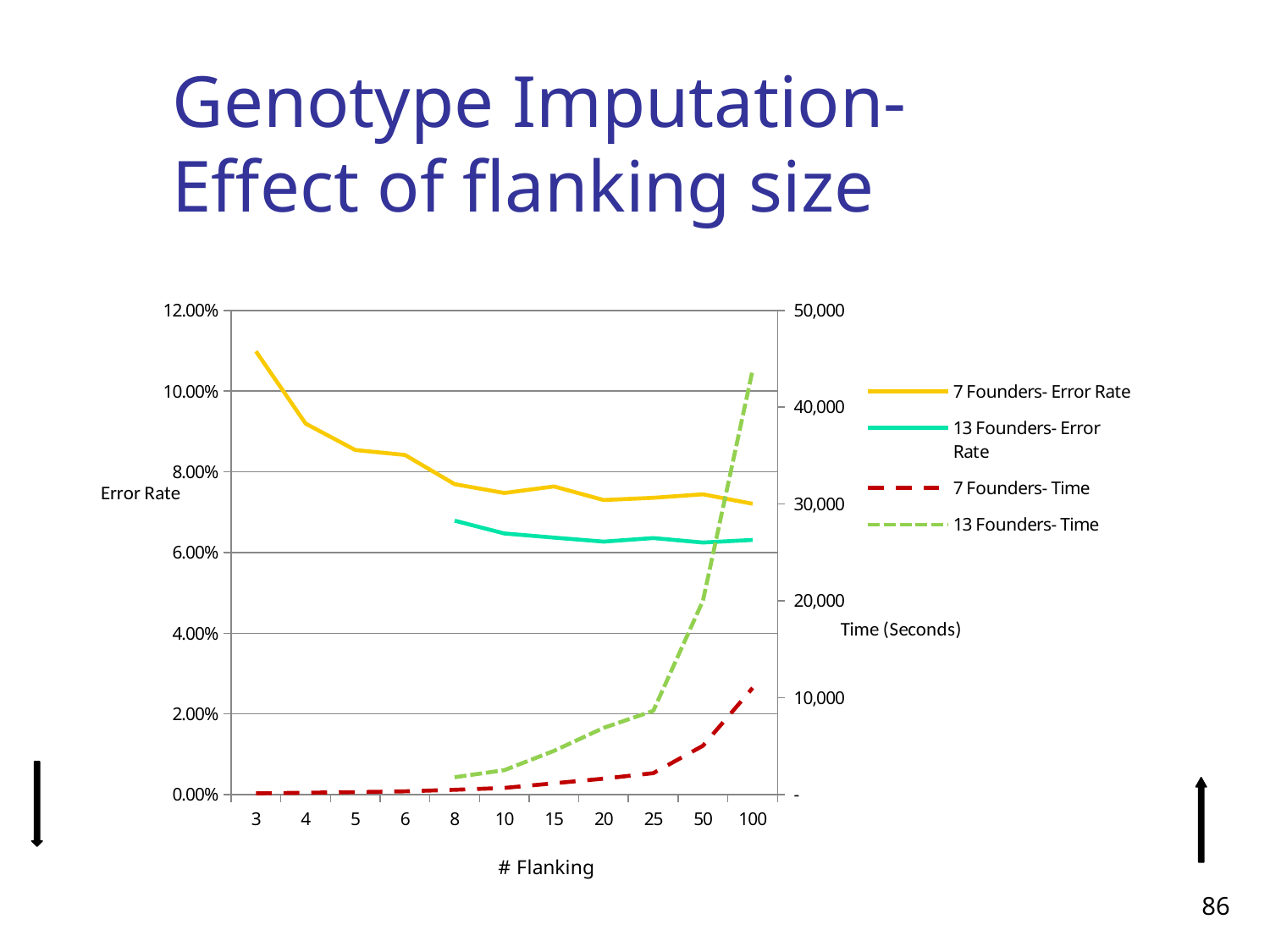
Does the 13 Founders- Time rise or fall as # Flanking increases? rise Is the 13 Founders- Time at # Flanking 25 greater or less than 10,000? less At which # Flanking value is the 7 Founders- Error Rate highest? 3 What is the title of the x axis? # Flanking How many series does the legend list? 4 Is the 7 Founders- Error Rate at # Flanking 3 greater or less than 10.00%? greater Is the 7 Founders- Error Rate at # Flanking 100 greater or less than 8.00%? less How many # Flanking values are shown on the x axis? 11 What kind of chart is shown on the slide? line chart At # Flanking 100, which is higher: the 7 Founders- Error Rate or the 13 Founders- Error Rate? 7 Founders- Error Rate Does the 7 Founders- Error Rate rise or fall as # Flanking increases? fall